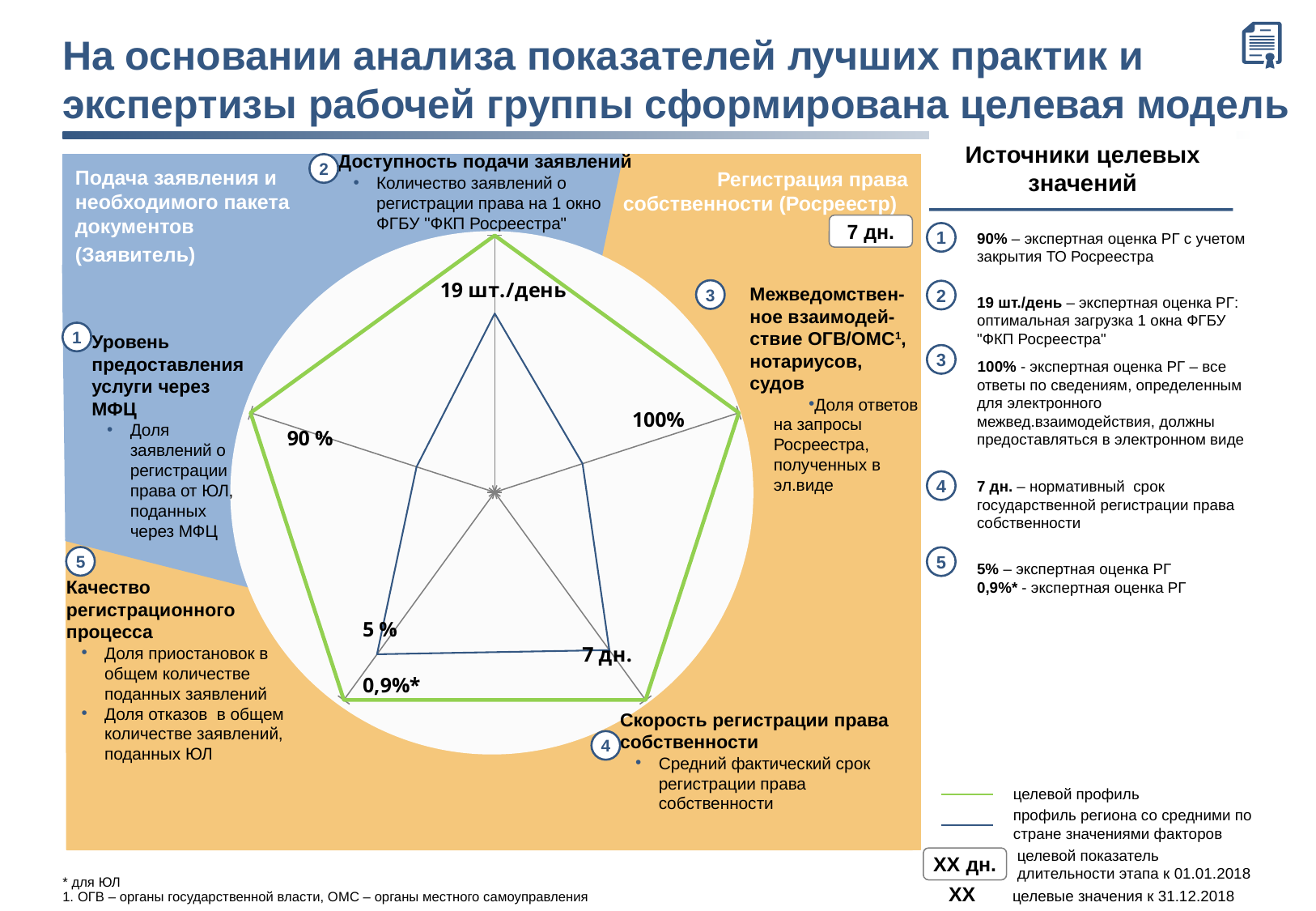
What is the target value shown on the chart for 'Доступность подачи заявлений'? 19 шт./день What colour is the line for 'профиль региона со средними по стране значениями факторов' in the legend? dark blue Which profile lies further from the centre of the radar chart on the 'Уровень предоставления услуги через МФЦ' axis, the target profile or the regional profile? целевой профиль What is the target value shown on the chart for 'Уровень предоставления услуги через МФЦ'? 90 % How many series does the chart legend list? 2 What target value is shown on the chart for the share of suspensions (доля приостановок) under 'Качество регистрационного процесса'? 5 % What target value is shown on the chart for the share of refusals (доля отказов) under 'Качество регистрационного процесса'? 0,9%* What is the target value shown on the chart for 'Скорость регистрации права собственности'? 7 дн. How many factors (axes) does the radar chart have? 5 What colour is the line for 'целевой профиль' in the legend? green What kind of chart is shown on the slide? radar chart What is the target value shown on the chart for 'Межведомственное взаимодействие ОГВ/ОМС, нотариусов, судов'? 100%